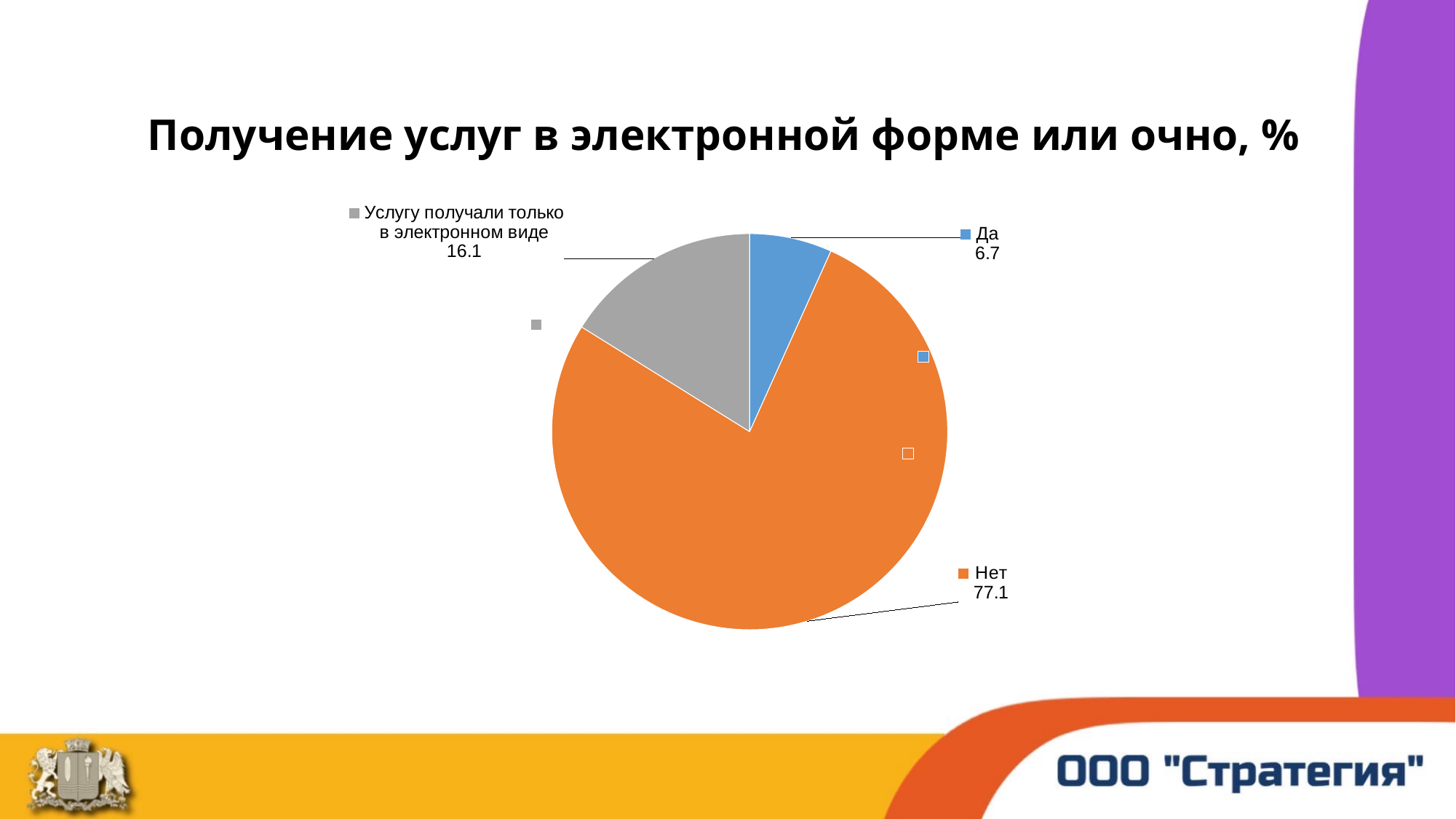
Which is larger: "Услугу получали только в электронном виде" or "Да"? Услугу получали только в электронном виде What is the value for the "Услугу получали только в электронном виде" slice? 16.1 Which slice is the largest? Нет What type of chart is shown on the slide? pie chart Which slice is the smallest? Да What is the value for the "Да" slice? 6.7 What is the title of the chart? Получение услуг в электронной форме или очно, % How many slices does the pie chart have? 3 What colour is the "Нет" slice? orange What is the difference between the "Нет" and "Да" values? 70.4 What is the difference between the "Услугу получали только в электронном виде" and "Да" values? 9.4 What is the value for the "Нет" slice? 77.1